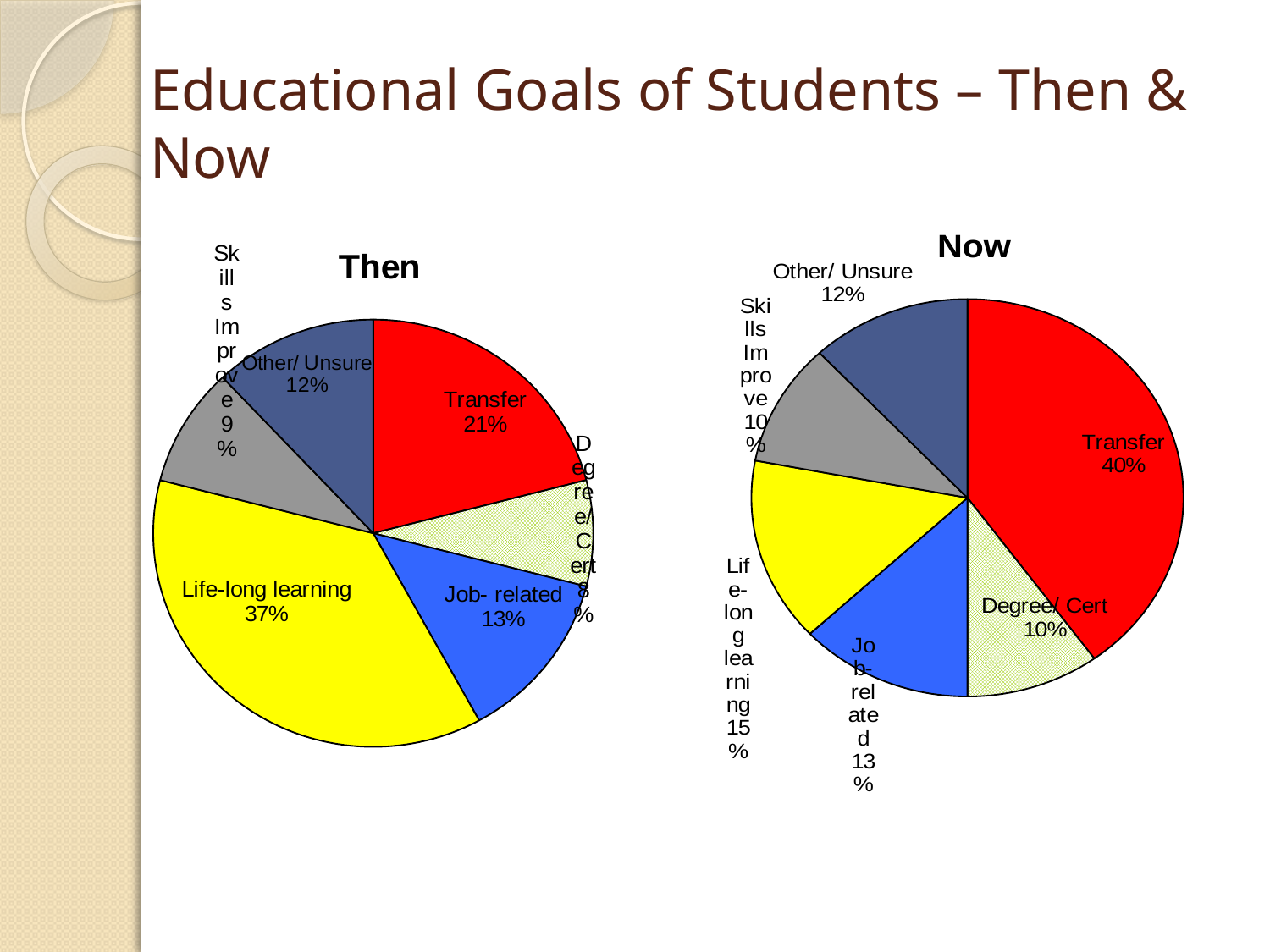
What is the difference between the Transfer share in the "Now" chart and the Transfer share in the "Then" chart? 19% In the "Then" pie chart, what share is Life-long learning? 37% In the "Now" pie chart, what share is Other/ Unsure? 12% In the "Then" pie chart, which category has the largest slice? Life-long learning In the "Now" pie chart, which category has the largest slice? Transfer In the "Then" pie chart, what share is Transfer? 21% How many categories does the "Now" pie chart show? 6 In the "Now" pie chart, what share is Transfer? 40% What kind of chart is the "Then" chart? Pie chart Is the Life-long learning share larger in the "Then" chart or the "Now" chart? Then In the "Then" pie chart, which category has the smallest slice? Degree/ Cert In the "Now" pie chart, what share is Degree/ Cert? 10%